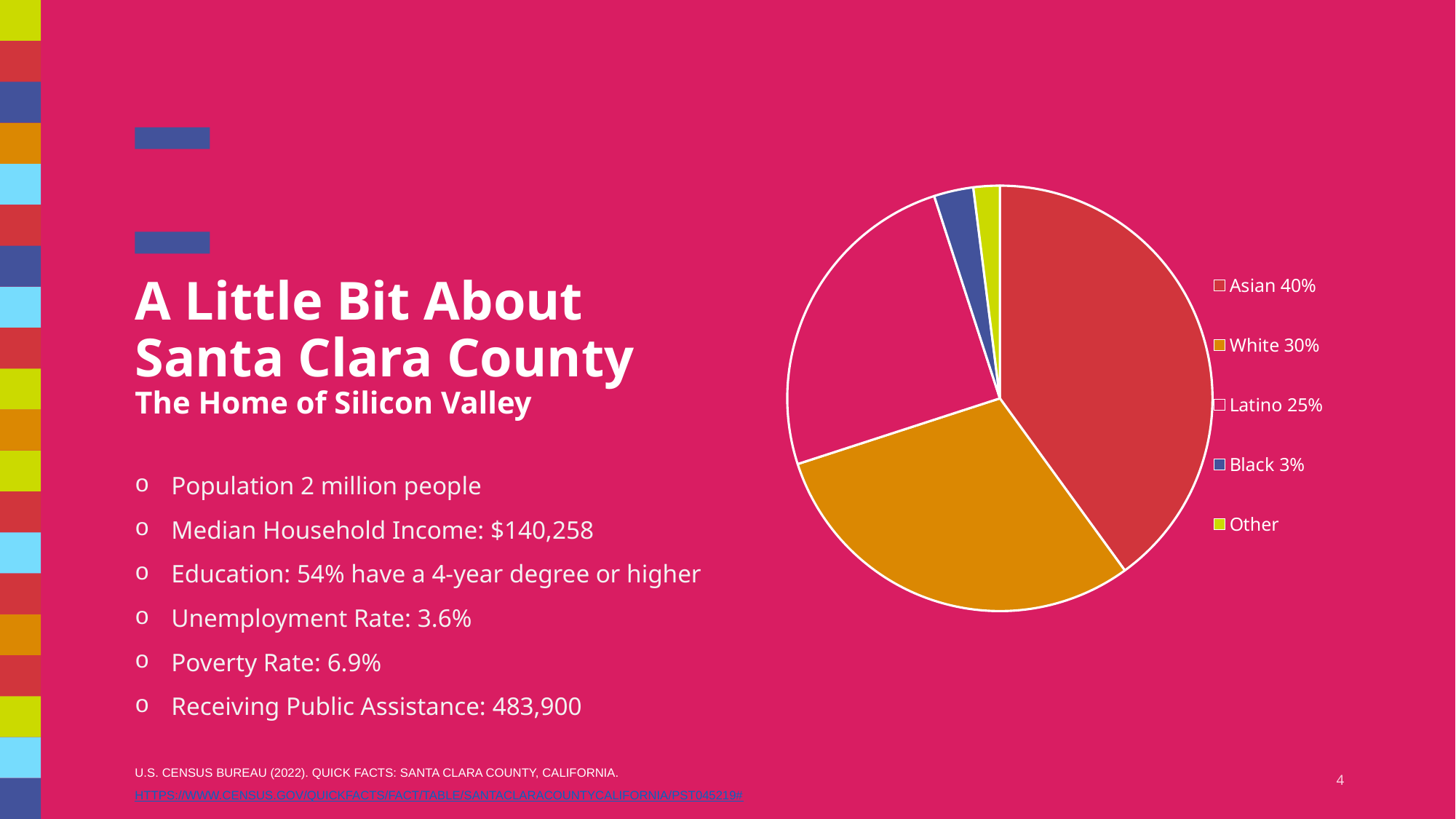
How many categories does the pie chart legend list? 5 Which legend entry has no percentage printed next to it? Other What percentage does the legend give for Asian? 40% What is the difference in percentage points between the Asian and White slices? 10 What percentage does the legend give for White? 30% What is the difference in percentage points between the Latino and Black slices? 22 What percentage does the legend give for Black? 3% What kind of chart is shown on the slide? pie chart What percentage does the legend give for Latino? 25% Which is larger, the White slice or the Latino slice? White Which category has the largest slice of the pie? Asian What share of the pie does the Asian slice represent? 40%